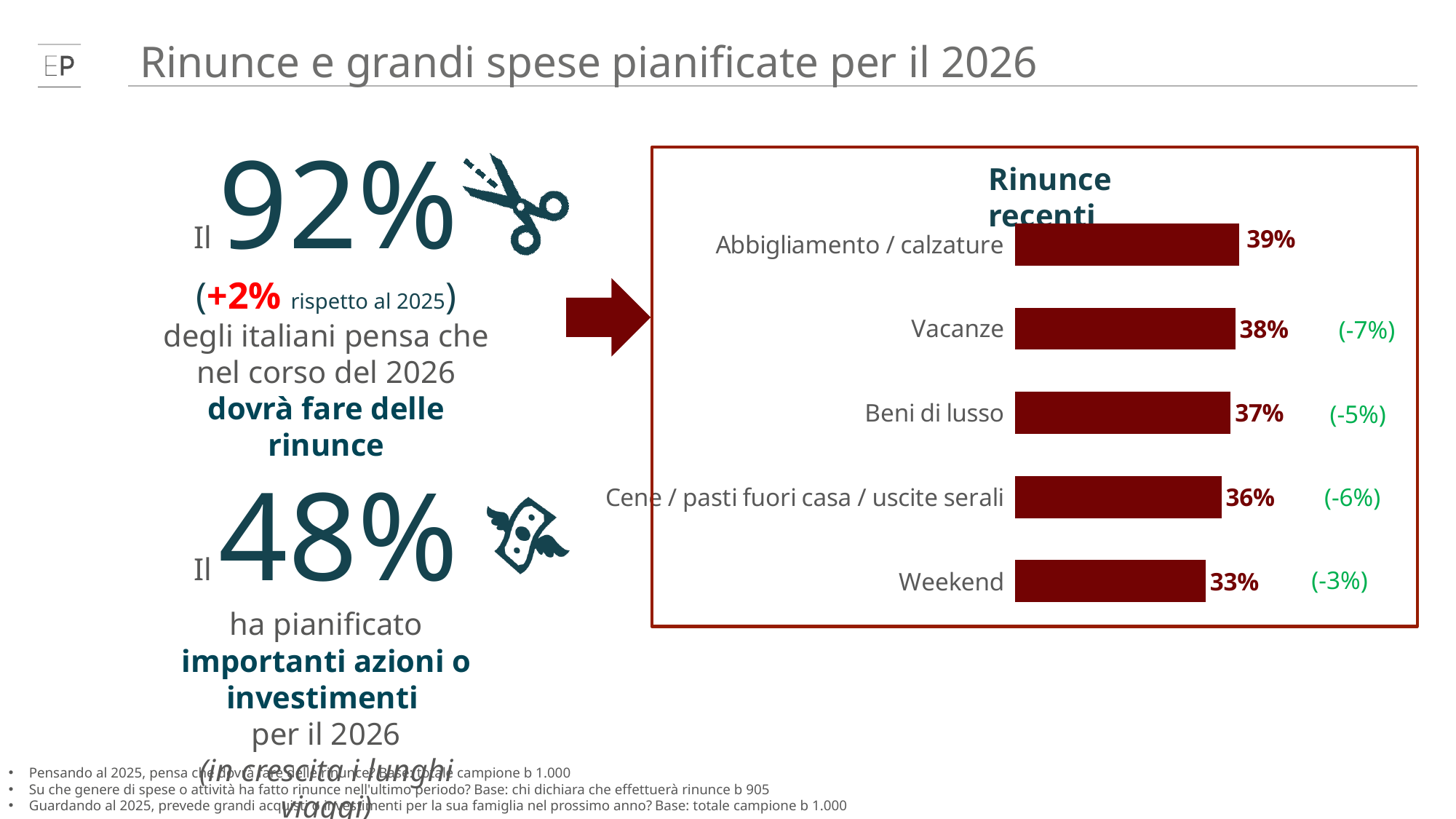
What is the difference between the values for Abbigliamento / calzature and Weekend in the Rinunce recenti chart? 6% What is the title of the chart on the slide? Rinunce recenti Which is larger in the Rinunce recenti chart: Vacanze or Cene / pasti fuori casa / uscite serali? Vacanze What kind of chart is the Rinunce recenti chart? Bar chart What is the value for Weekend in the Rinunce recenti chart? 33% Which category has the lowest value in the Rinunce recenti chart? Weekend What change versus the previous year is shown next to Vacanze in the Rinunce recenti chart? (-7%) What is the value for Cene / pasti fuori casa / uscite serali in the Rinunce recenti chart? 36% Which category has the highest value in the Rinunce recenti chart? Abbigliamento / calzature How many categories are shown in the Rinunce recenti chart? 5 What is the value for Beni di lusso in the Rinunce recenti chart? 37% What is the value for Abbigliamento / calzature in the Rinunce recenti chart? 39%